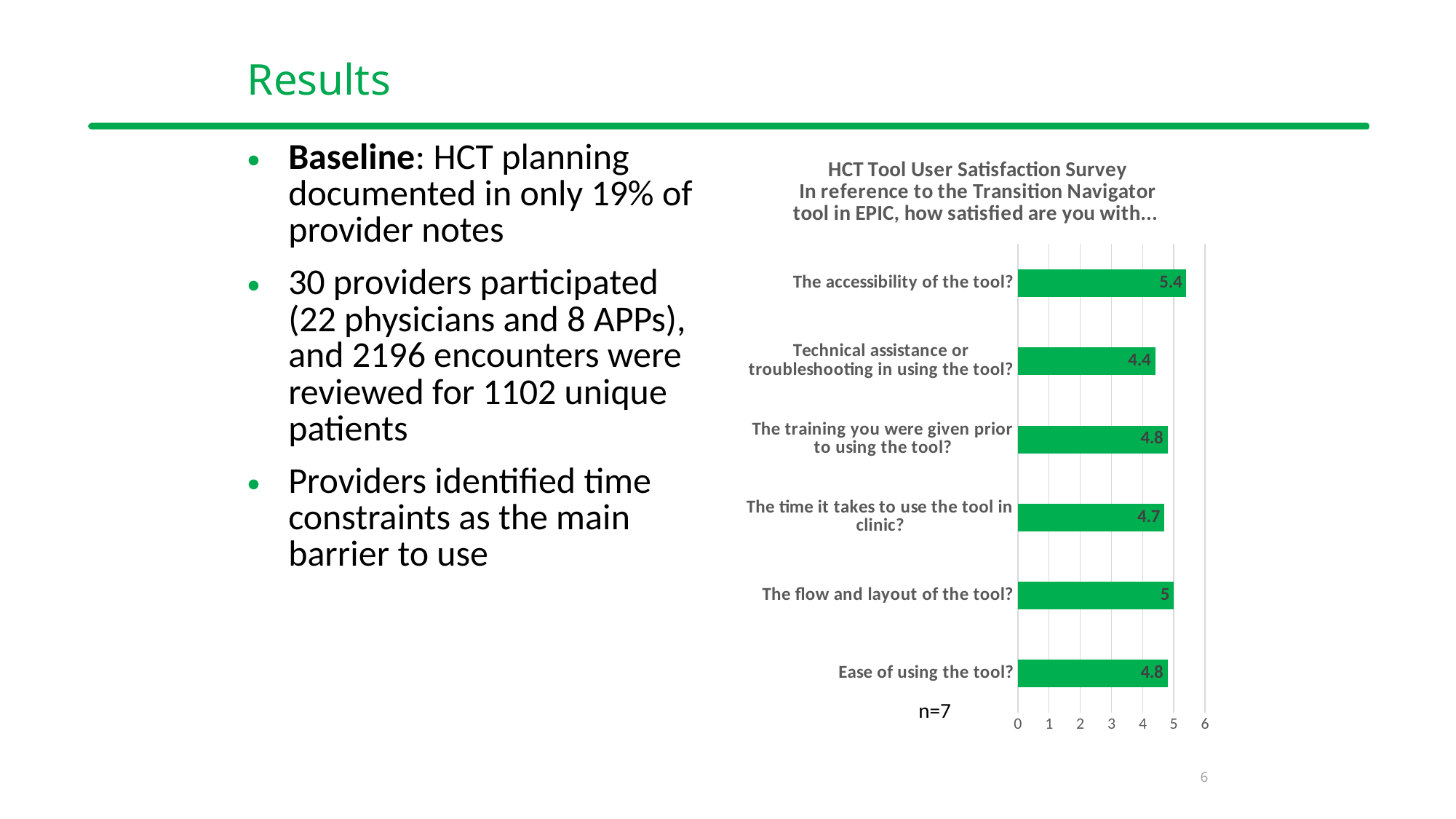
Which has a higher value: 'The flow and layout of the tool?' or 'The time it takes to use the tool in clinic?' The flow and layout of the tool? How many survey items are shown in the chart? 6 Which survey item has the highest satisfaction value? The accessibility of the tool? What is the satisfaction value for 'Ease of using the tool?' 4.8 What sample size (n) is noted below the chart? n=7 What type of chart is shown on the slide? Bar chart What is the satisfaction value for 'The accessibility of the tool?' 5.4 Is the value for 'The training you were given prior to using the tool?' greater or less than 4? greater What is the satisfaction value for 'The flow and layout of the tool?' 5 Which survey item has the lowest satisfaction value? Technical assistance or troubleshooting in using the tool? What is the difference between the values for 'The accessibility of the tool?' and 'Technical assistance or troubleshooting in using the tool?' 1 What is the satisfaction value for 'Technical assistance or troubleshooting in using the tool?' 4.4